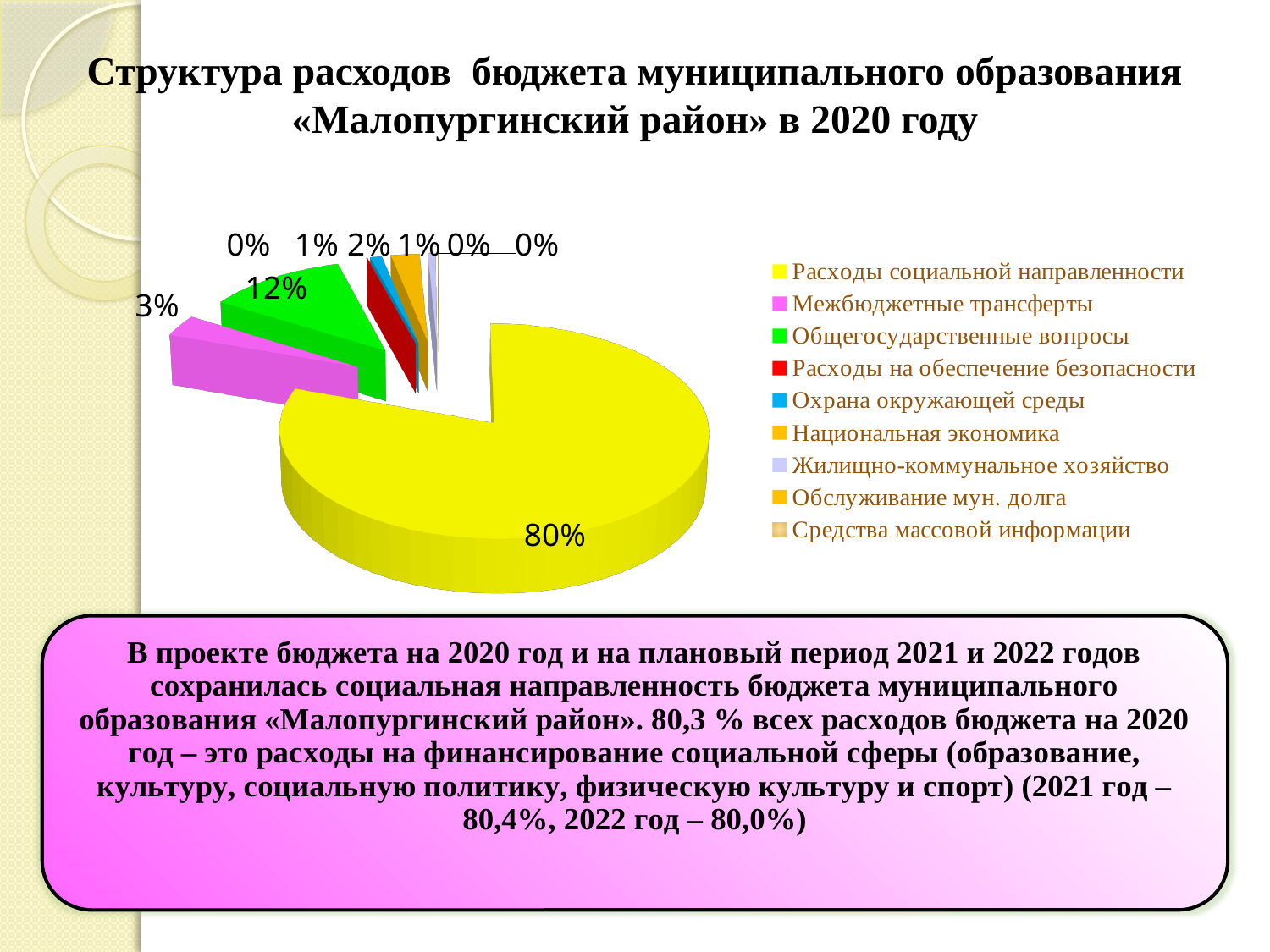
What colour is the slice for «Расходы социальной направленности»? yellow What share of the pie does «Межбюджетные трансферты» take? 3% Which is larger: the slice for «Общегосударственные вопросы» or the slice for «Межбюджетные трансферты»? Общегосударственные вопросы What share of the pie does «Общегосударственные вопросы» take? 12% What kind of chart is shown on the slide? pie chart By how many percentage points does the «Общегосударственные вопросы» slice exceed the «Межбюджетные трансферты» slice? 9 percentage points What colour is the slice for «Межбюджетные трансферты»? pink By how many percentage points does the «Расходы социальной направленности» slice exceed the «Общегосударственные вопросы» slice? 68 percentage points How many categories does the legend list? 9 What share of the pie does «Расходы социальной направленности» take? 80% Which category has the largest slice of the pie? Расходы социальной направленности